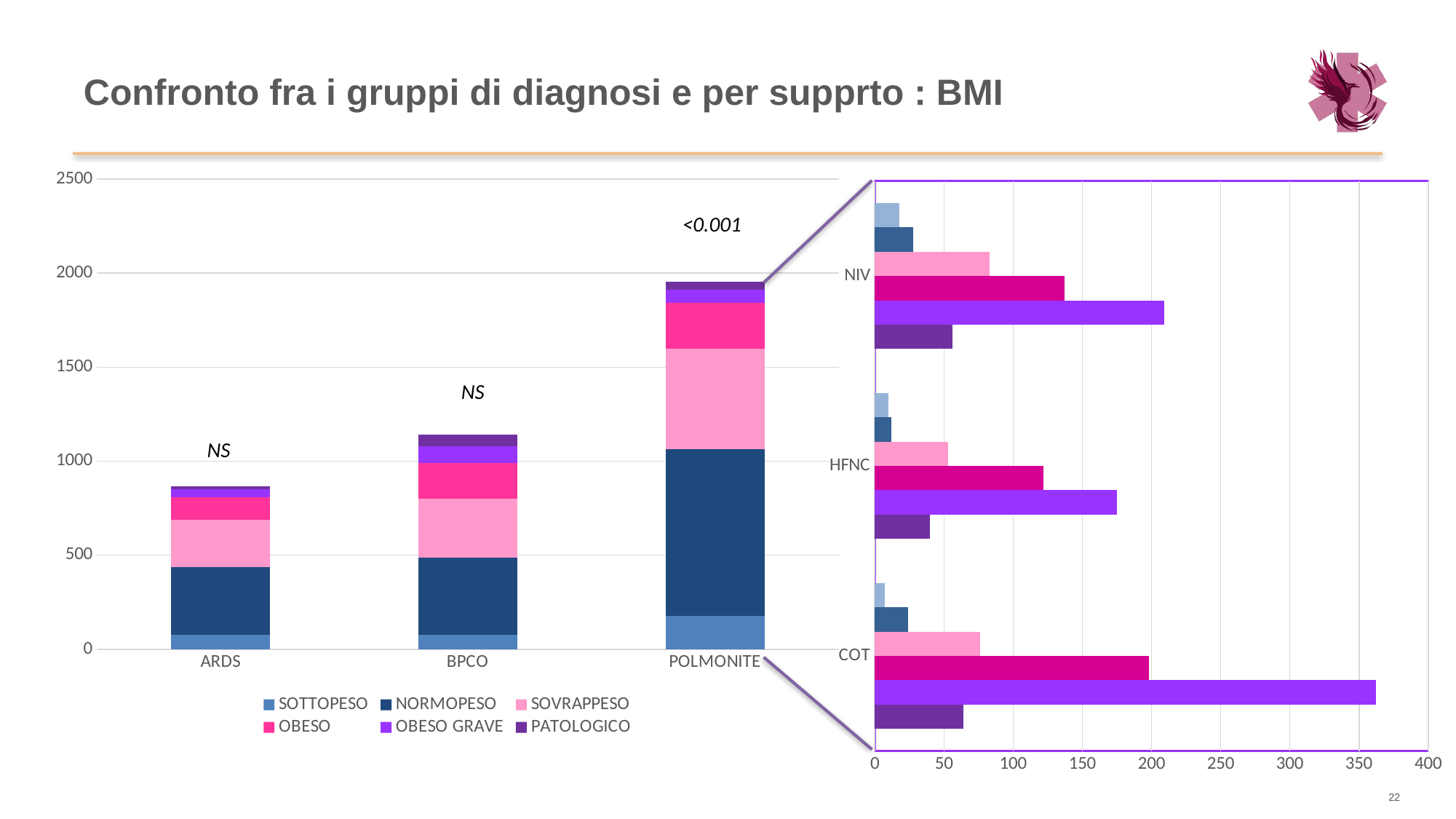
In the left stacked chart, what p-value annotation is printed above the POLMONITE bar? <0.001 In the left stacked chart, which diagnosis group has the shortest total bar? ARDS In the left stacked chart, which diagnosis group has the tallest total bar? POLMONITE In the left stacked chart, is the total for ARDS greater or less than 1000? less How many series does the legend of the left stacked chart list? 6 What kind of chart is the chart on the right of the slide? bar chart In the left stacked chart, how many diagnosis groups are shown on the x axis? 3 In the left stacked chart, is the total for POLMONITE greater or less than 1500? greater